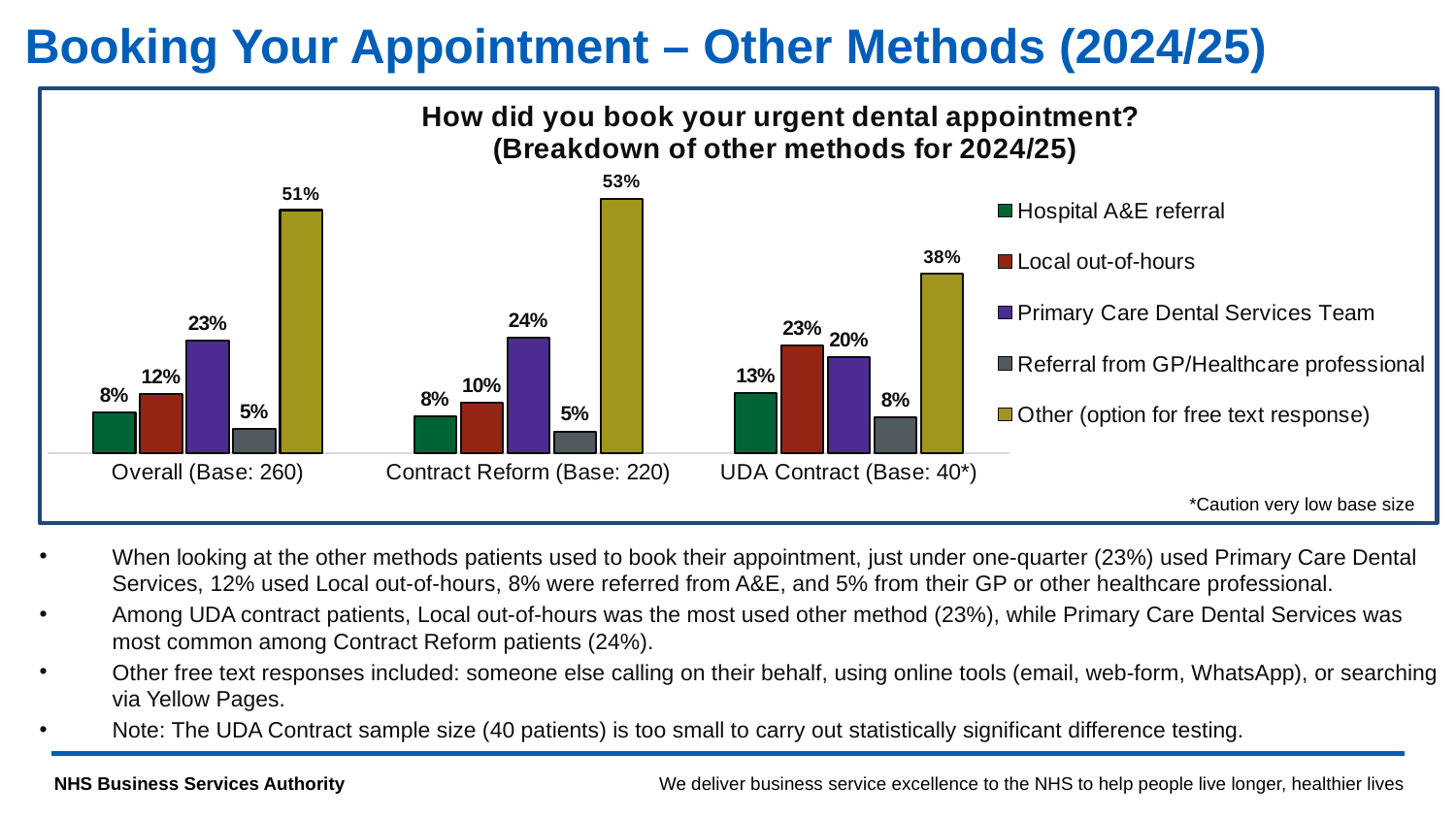
Which method has the highest value in the UDA Contract group? Other (option for free text response) In the UDA Contract group, which is larger: Local out-of-hours or Primary Care Dental Services Team? Local out-of-hours What is the base size for the Contract Reform group? 220 What kind of chart is shown? Bar chart What is the difference between the Other value for Contract Reform and the Other value for UDA Contract? 15% Which method has the lowest value in the Overall group? Referral from GP/Healthcare professional What percentage of UDA Contract respondents booked via Hospital A&E referral? 13% What is the value for Primary Care Dental Services Team in the Contract Reform group? 24% How many series does the legend list? 5 What colour are the bars for Hospital A&E referral? Green What percentage of Overall respondents booked via Local out-of-hours? 12% How many groups are shown on the x axis? 3